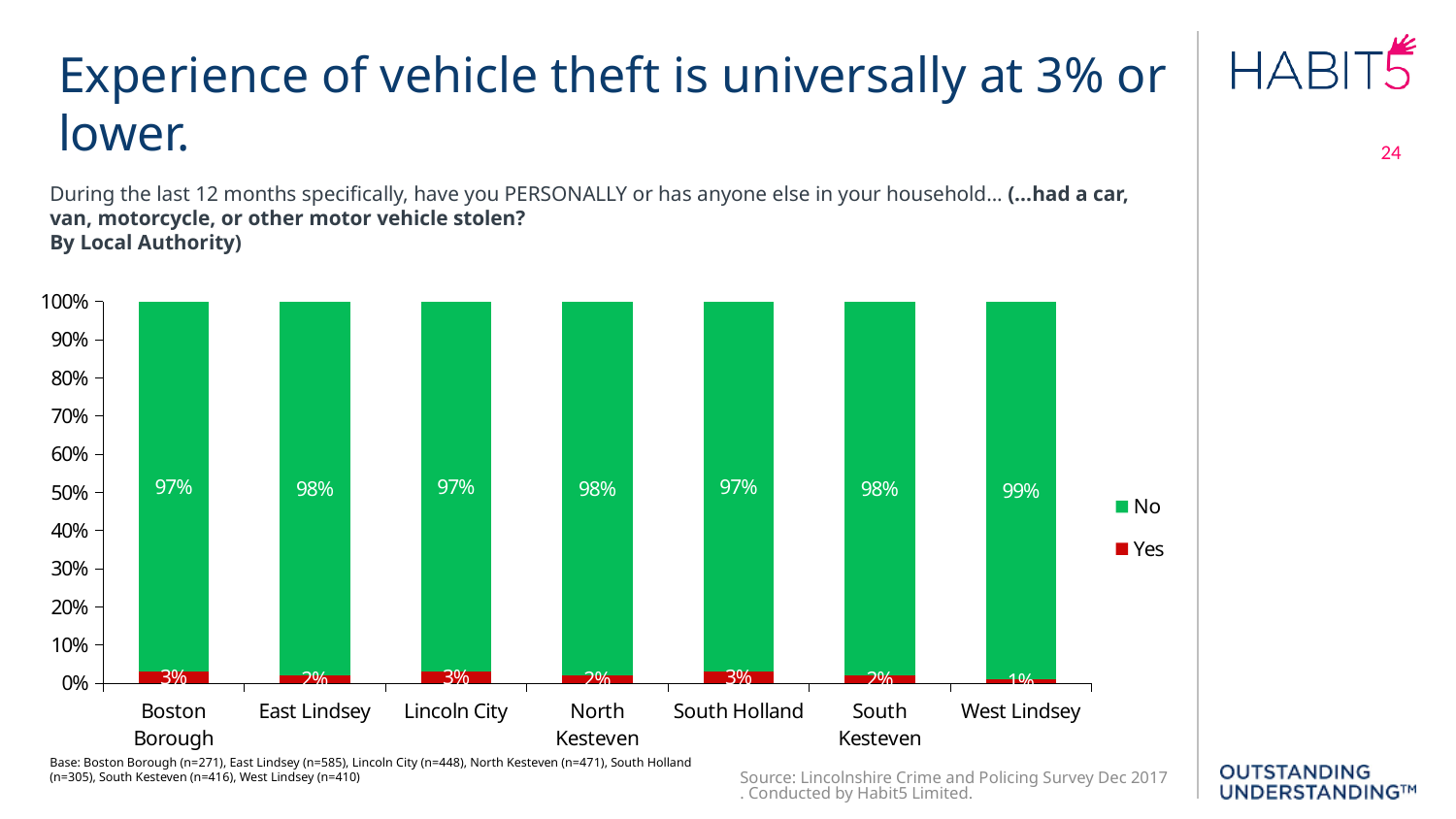
How many series does the legend list? 2 What is the difference between the 'Yes' values for South Holland and West Lindsey? 2% What is the 'No' value for South Kesteven? 98% What percentage of respondents in Boston Borough answered 'No'? 97% Which local authority has the highest 'No' percentage? West Lindsey What is the total of the stacked bar for North Kesteven? 100% What percentage of respondents in West Lindsey answered 'Yes'? 1% What is the 'Yes' value for Lincoln City? 3% Which is larger, the 'Yes' value for Boston Borough or the 'Yes' value for East Lindsey? Boston Borough Which local authority has the lowest 'Yes' percentage? West Lindsey What kind of chart is shown on the slide? Stacked bar chart How many local authorities are shown on the x axis? 7